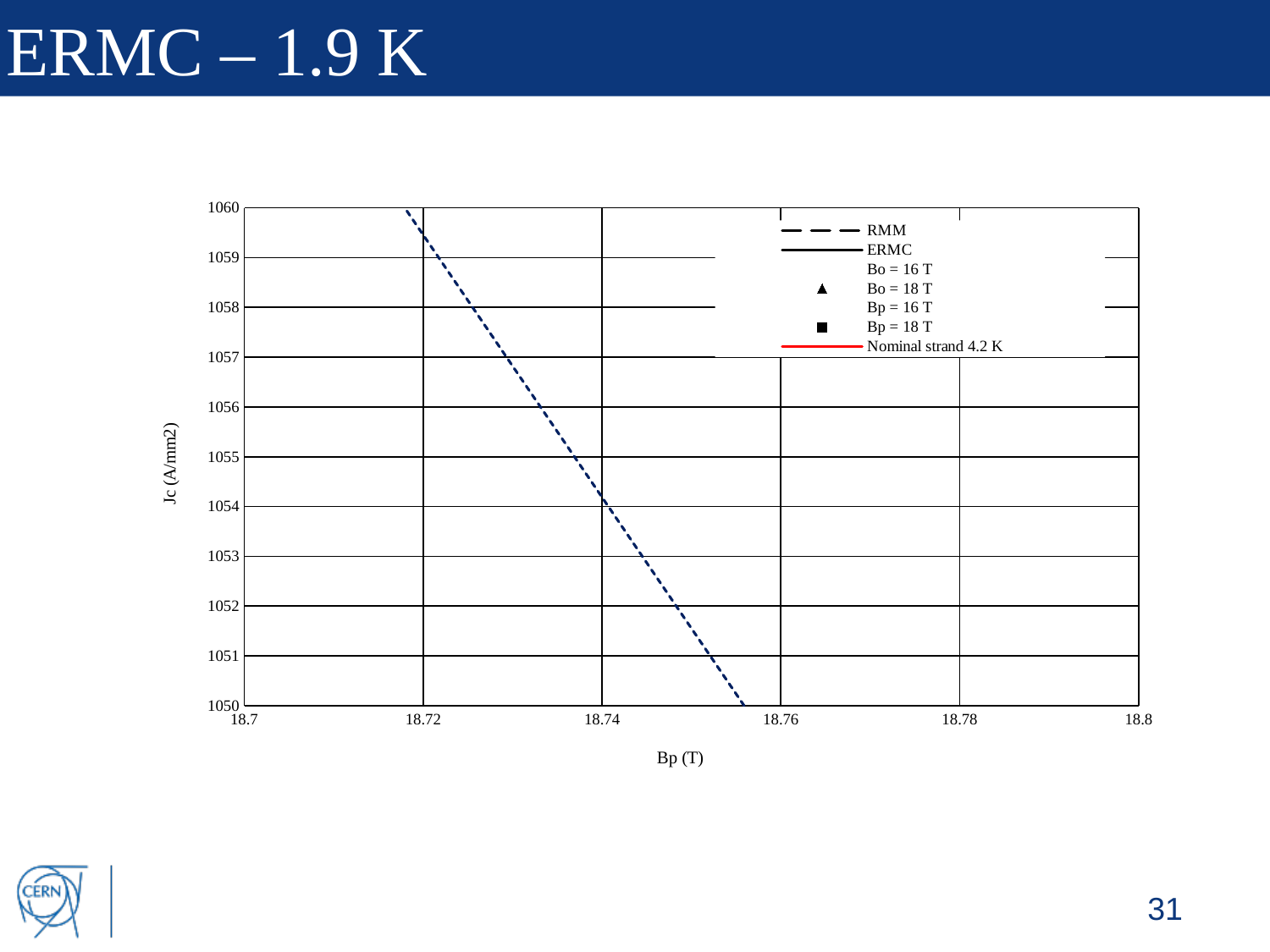
Is the value of the RMM line at Bp = 18.73 T greater or less than 1055? greater Does the dashed RMM line rise or fall as Bp increases along the x axis? fall What kind of chart is shown on the slide? line chart Is the value of the RMM line at Bp = 18.75 T greater or less than 1053? less What is the label of the x axis? Bp (T) What is the label of the y axis? Jc (A/mm2) How many entries does the legend list? 7 Is the value of the RMM line at Bp = 18.72 T greater or less than 1058? greater